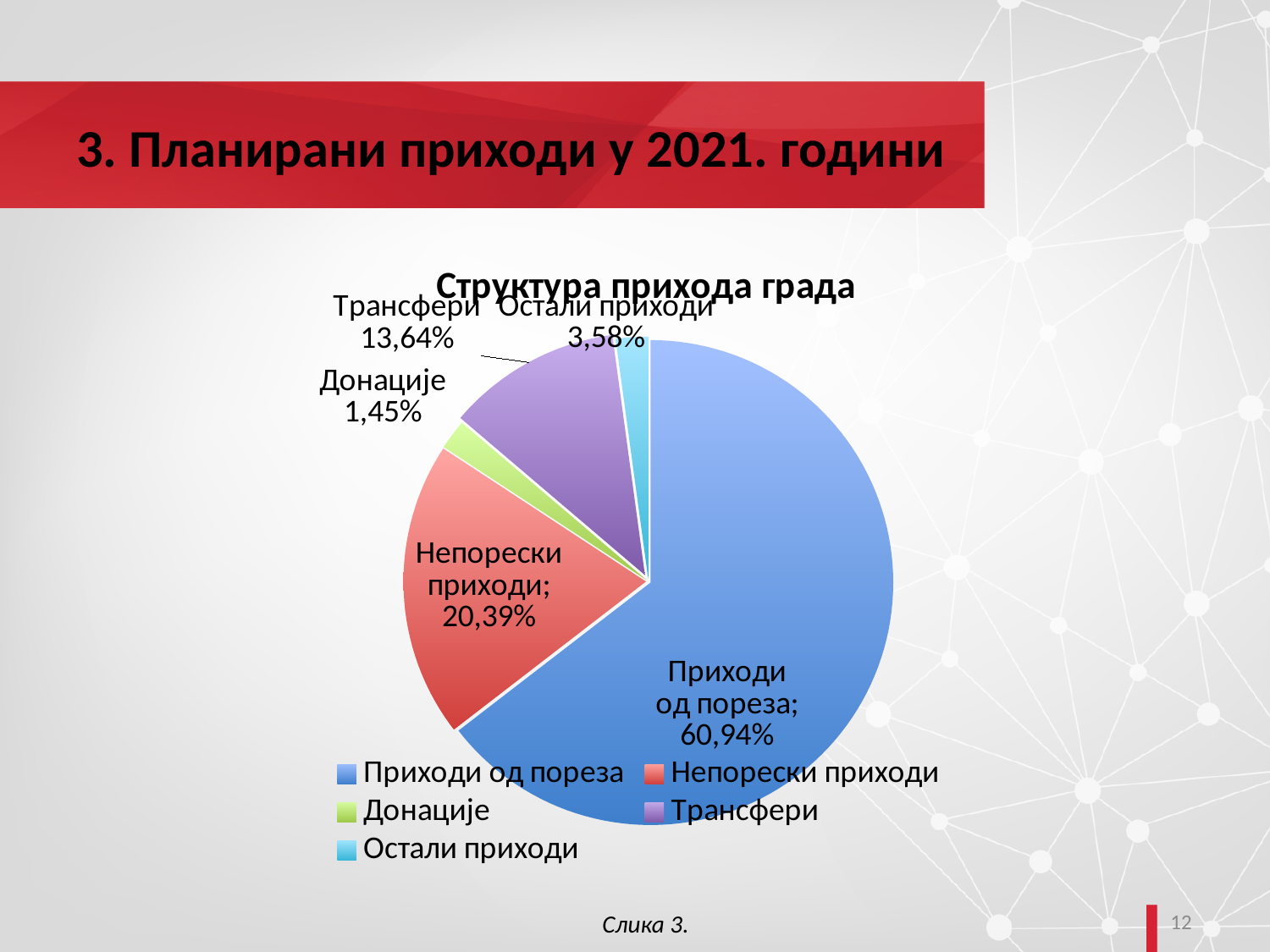
How many categories does the legend list? 5 What is the difference between the shares of Приходи од пореза and Непорески приходи? 40,55% What is the title of the chart? Структура прихода града What kind of chart is shown on the slide? Pie chart What share of the pie does Остали приходи have? 3,58% Which category has the largest slice of the pie? Приходи од пореза What share of the pie does Непорески приходи have? 20,39% Which category has the smallest slice of the pie? Донације What share of the pie does Донације have? 1,45% What share of the pie does Приходи од пореза have? 60,94% Which is larger, the share for Трансфери or the share for Остали приходи? Трансфери What share of the pie does Трансфери have? 13,64%